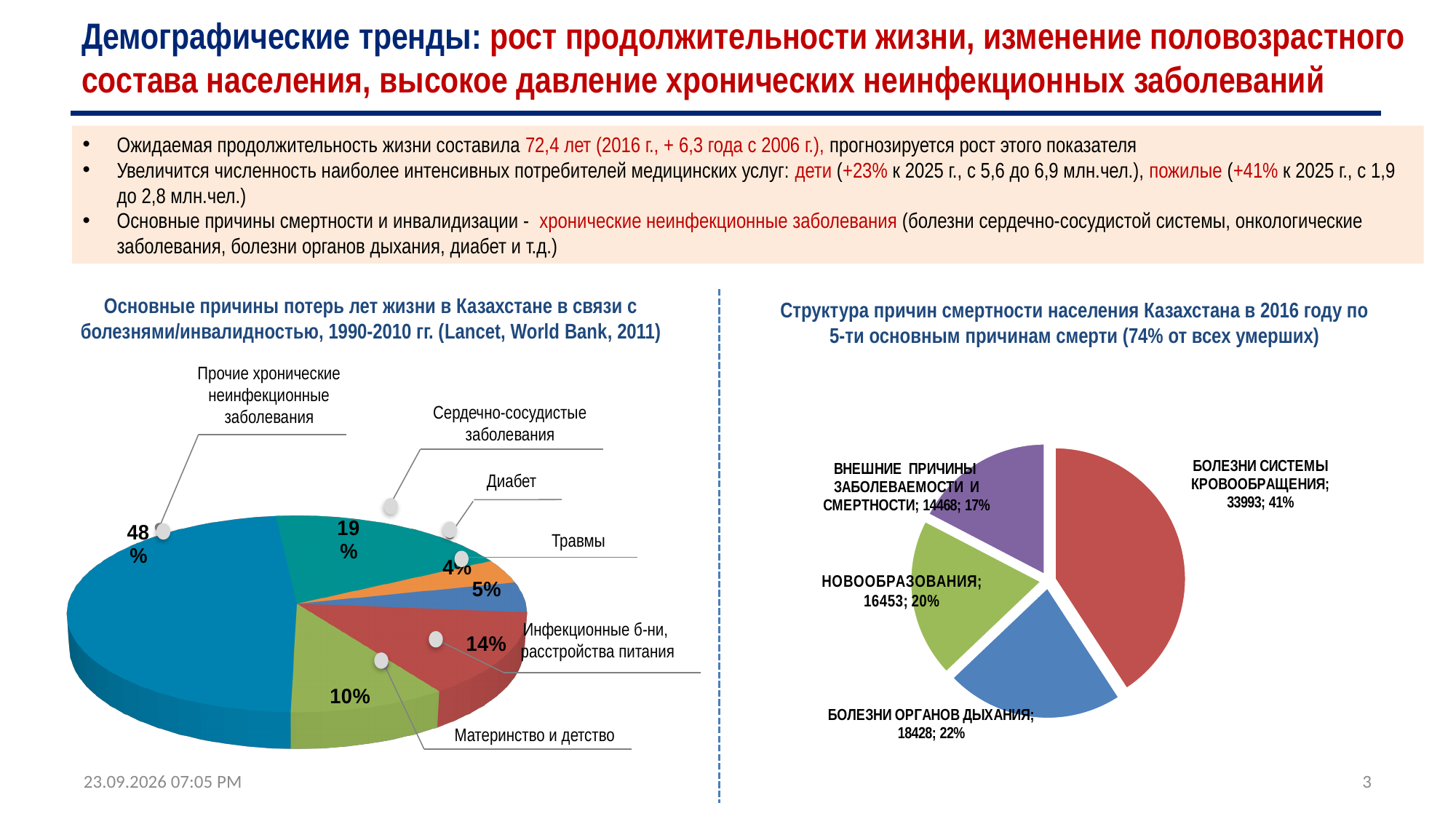
In the left chart, which category has the smallest share? Диабет In the right chart, which category has the smallest value? Внешние причины заболеваемости и смертности In the left chart, which category has the largest share? Прочие хронические неинфекционные заболевания In the right chart, how many categories are shown? 4 In the right chart, what value is shown for 'Новообразования'? 16453; 20% In the left chart, what share is shown for 'Прочие хронические неинфекционные заболевания'? 48% What kind of chart is the left chart, 'Основные причины потерь лет жизни в Казахстане'? Pie chart In the left chart, what share is shown for 'Материнство и детство'? 10% In the right chart, what is the difference between the values for 'Болезни органов дыхания' and 'Внешние причины заболеваемости и смертности'? 3960 In the left chart, how many categories are shown? 6 In the right chart, 'Структура причин смертности населения Казахстана в 2016 году', what value is shown for 'Болезни системы кровообращения'? 33993; 41% In the left chart, what share is shown for 'Сердечно-сосудистые заболевания'? 19%